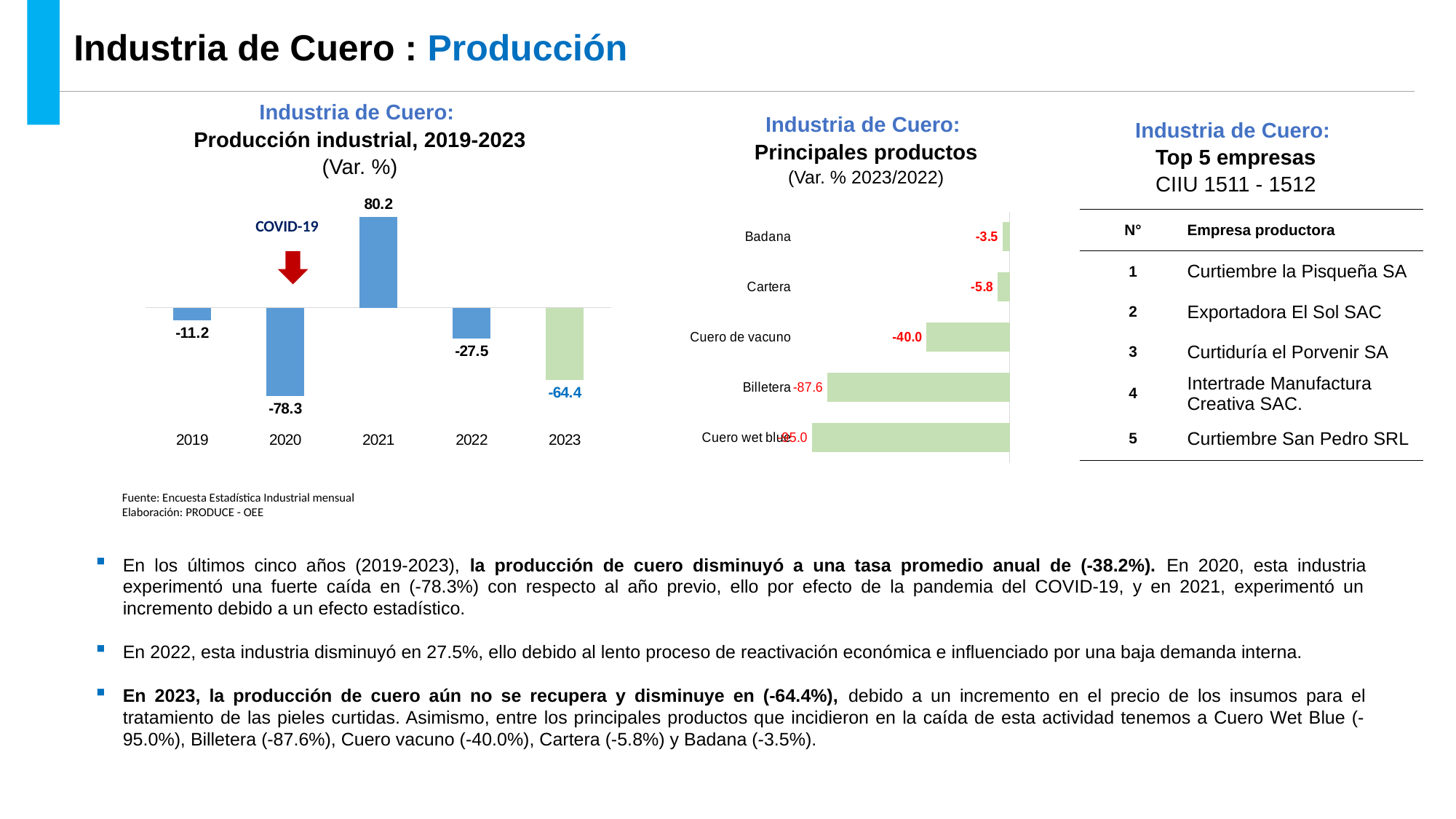
In the 'Producción industrial, 2019-2023' chart, how many years are plotted? 5 In the 'Principales productos' chart, what is the value for Billetera? -87.6 In the 'Principales productos' chart, which product has the smallest decline (value closest to zero)? Badana What type of chart is the 'Producción industrial, 2019-2023' chart? Bar chart In the 'Producción industrial, 2019-2023' chart, what is the value for 2021? 80.2 In the 'Producción industrial, 2019-2023' chart, what is the value for 2023? -64.4 In the 'Producción industrial, 2019-2023' chart, which year has the lowest value? 2020 In the 'Principales productos' chart, what is the value for Cuero de vacuno? -40.0 In the 'Producción industrial, 2019-2023' chart, what is the difference between the 2019 value and the 2022 value? 16.3 In the 'Principales productos' chart, which is larger, the value for Cartera or the value for Badana? Badana In the 'Producción industrial, 2019-2023' chart, which year has the highest value? 2021 In the 'Producción industrial, 2019-2023' chart, what is the value for 2020? -78.3